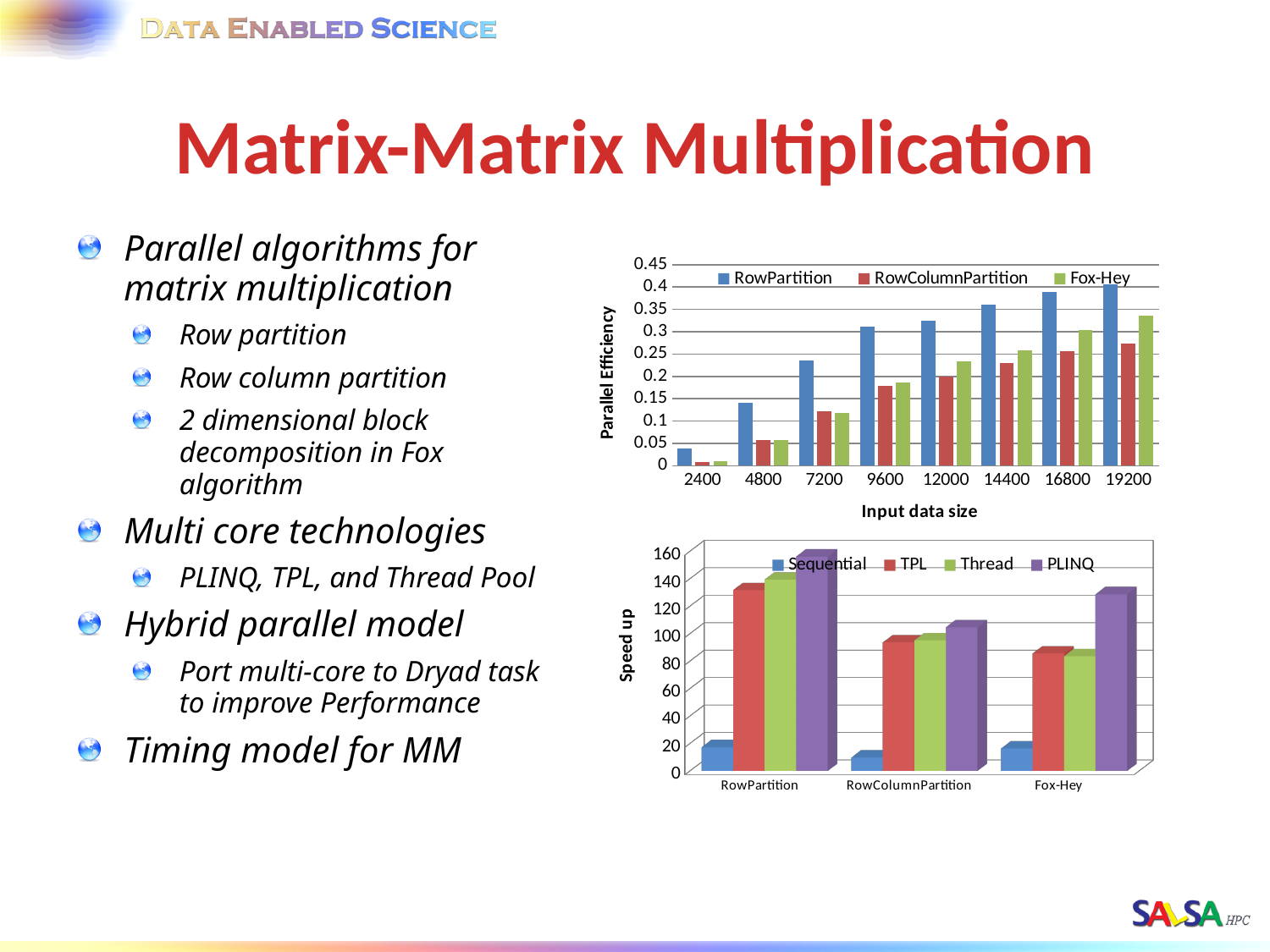
In the bottom chart (Speed up), how many series does the legend list? 4 In the bottom chart (Speed up), which series has the lowest speed up for Fox-Hey? Sequential In the top chart (Parallel Efficiency), is the RowPartition value at 7200 greater or less than 0.2? greater In the bottom chart (Speed up), is the PLINQ value for Fox-Hey greater or less than 120? greater In the top chart (Parallel Efficiency), which series has the highest value at input data size 19200? RowPartition In the top chart (Parallel Efficiency), which is larger at input data size 12000: RowPartition or RowColumnPartition? RowPartition What kind of chart is the bottom chart (Speed up)? bar chart In the top chart (Parallel Efficiency), is the Fox-Hey value at 19200 greater or less than 0.3? greater In the top chart (Parallel Efficiency), how many series does the legend list? 3 In the bottom chart (Speed up), which series has the highest speed up for RowPartition? PLINQ In the top chart (Parallel Efficiency), does the RowPartition value rise or fall as input data size increases? rise In the top chart (Parallel Efficiency), how many input data sizes are shown on the x axis? 8